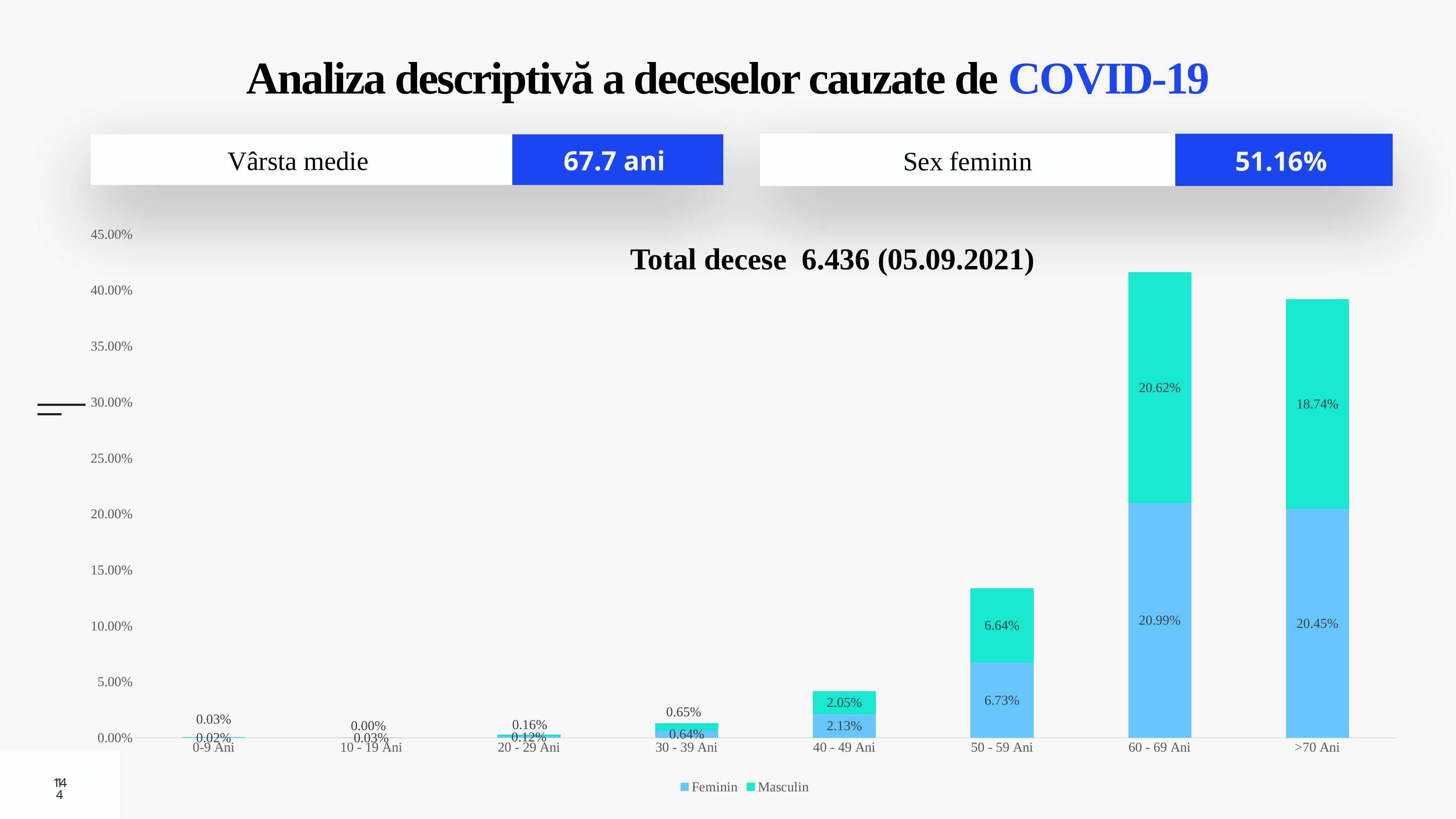
What is the Masculin value for the >70 Ani age group? 18.74% What is the total stacked value for the 60 - 69 Ani age group? 41.61% What is the Feminin value for the 60 - 69 Ani age group? 20.99% Which age group has the highest Masculin value? 60 - 69 Ani How many age groups are shown on the x axis? 8 What is the Masculin value for the 50 - 59 Ani age group? 6.64% What is the Feminin value for the 40 - 49 Ani age group? 2.13% Which age group has the lowest Masculin value? 10 - 19 Ani What is the difference between the Feminin and Masculin values for the >70 Ani age group? 1.71% What kind of chart is shown on the slide? Stacked bar chart Which is larger for the >70 Ani age group, the Feminin value or the Masculin value? Feminin How many series does the legend list? 2